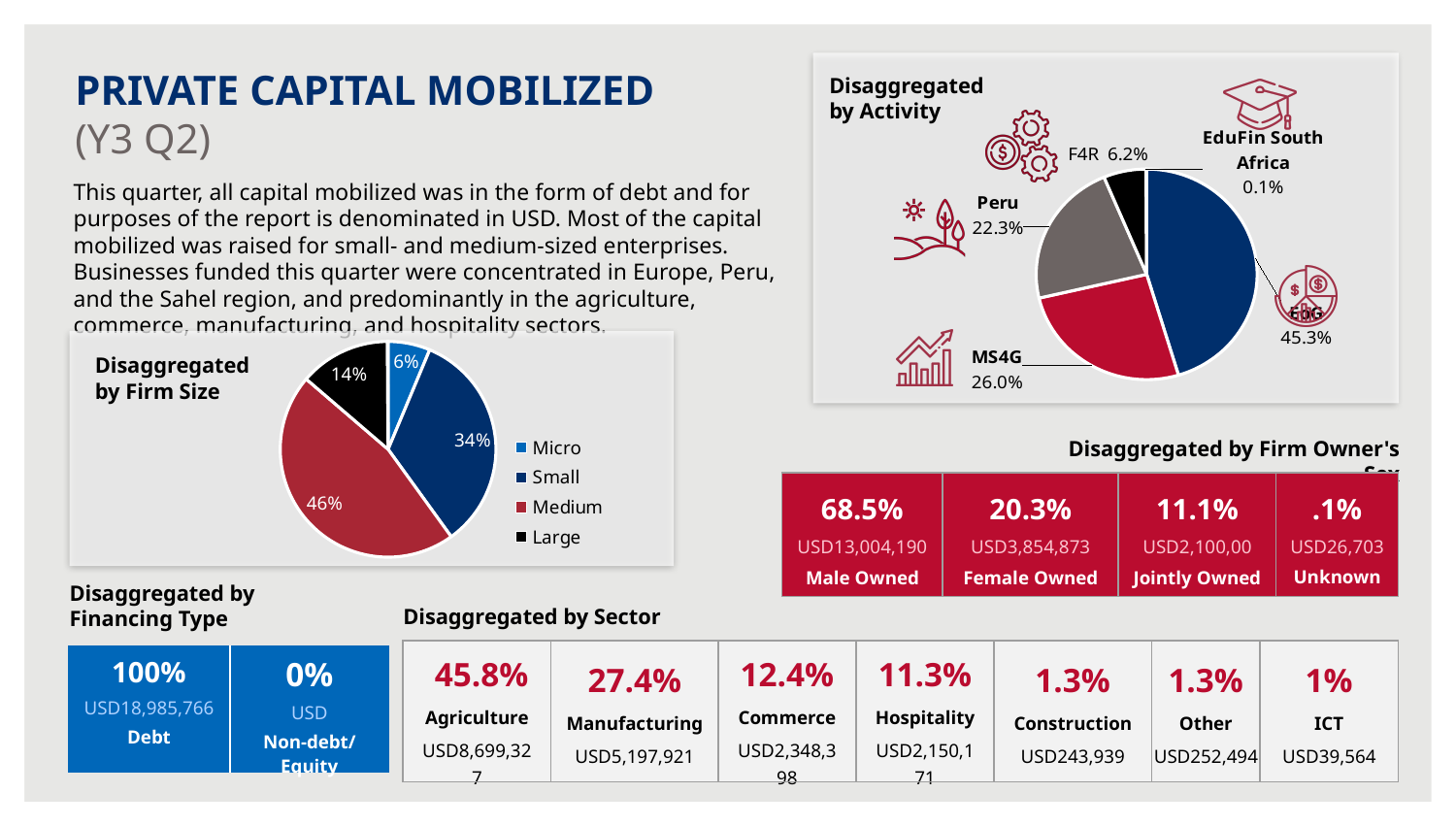
In the 'Disaggregated by Activity' chart, what share of the pie is MS4G? 26.0% In the 'Disaggregated by Firm Size' chart, what is the difference in percentage points between Medium and Small? 12 In the 'Disaggregated by Firm Size' chart, which firm size has the largest share? Medium In the 'Disaggregated by Firm Size' chart, how many entries does the legend list? 4 In the 'Disaggregated by Firm Size' chart, what share of the pie is Micro? 6% In the 'Disaggregated by Firm Size' chart, what share of the pie is Medium? 46% In the 'Disaggregated by Activity' chart, which is larger, F4R or Peru? Peru What type of chart is the 'Disaggregated by Firm Size' chart? Pie chart In the 'Disaggregated by Activity' chart, how many slices does the pie have? 5 In the 'Disaggregated by Activity' chart, what share of the pie is Peru? 22.3% In the 'Disaggregated by Firm Size' chart, which firm size has the smallest share? Micro In the 'Disaggregated by Activity' chart, which activity has the smallest share? EduFin South Africa